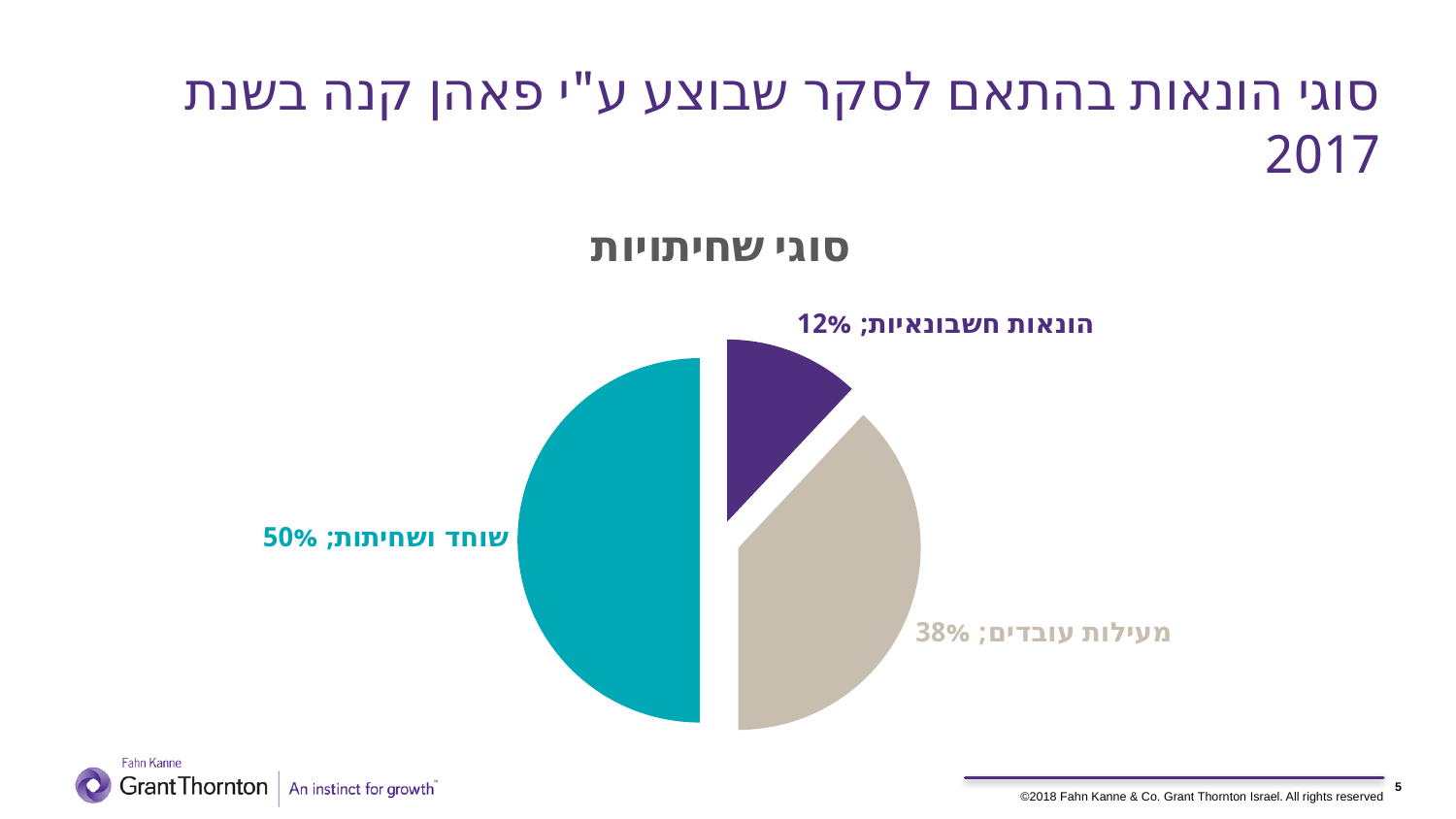
What kind of chart is shown on the slide? pie chart Which is larger, the slice for מעילות עובדים or the slice for הונאות חשבונאיות? מעילות עובדים What is the difference in percentage points between מעילות עובדים and הונאות חשבונאיות? 26 What share of the pie does מעילות עובדים represent? 38% Which category has the smallest slice of the pie? הונאות חשבונאיות What is the title of the chart? סוגי שחיתויות What is the difference in percentage points between שוחד ושחיתות and מעילות עובדים? 12 What colour is the slice for שוחד ושחיתות? teal What share of the pie does שוחד ושחיתות represent? 50% What share of the pie does הונאות חשבונאיות represent? 12% How many slices does the pie chart have? 3 Which category has the largest slice of the pie? שוחד ושחיתות